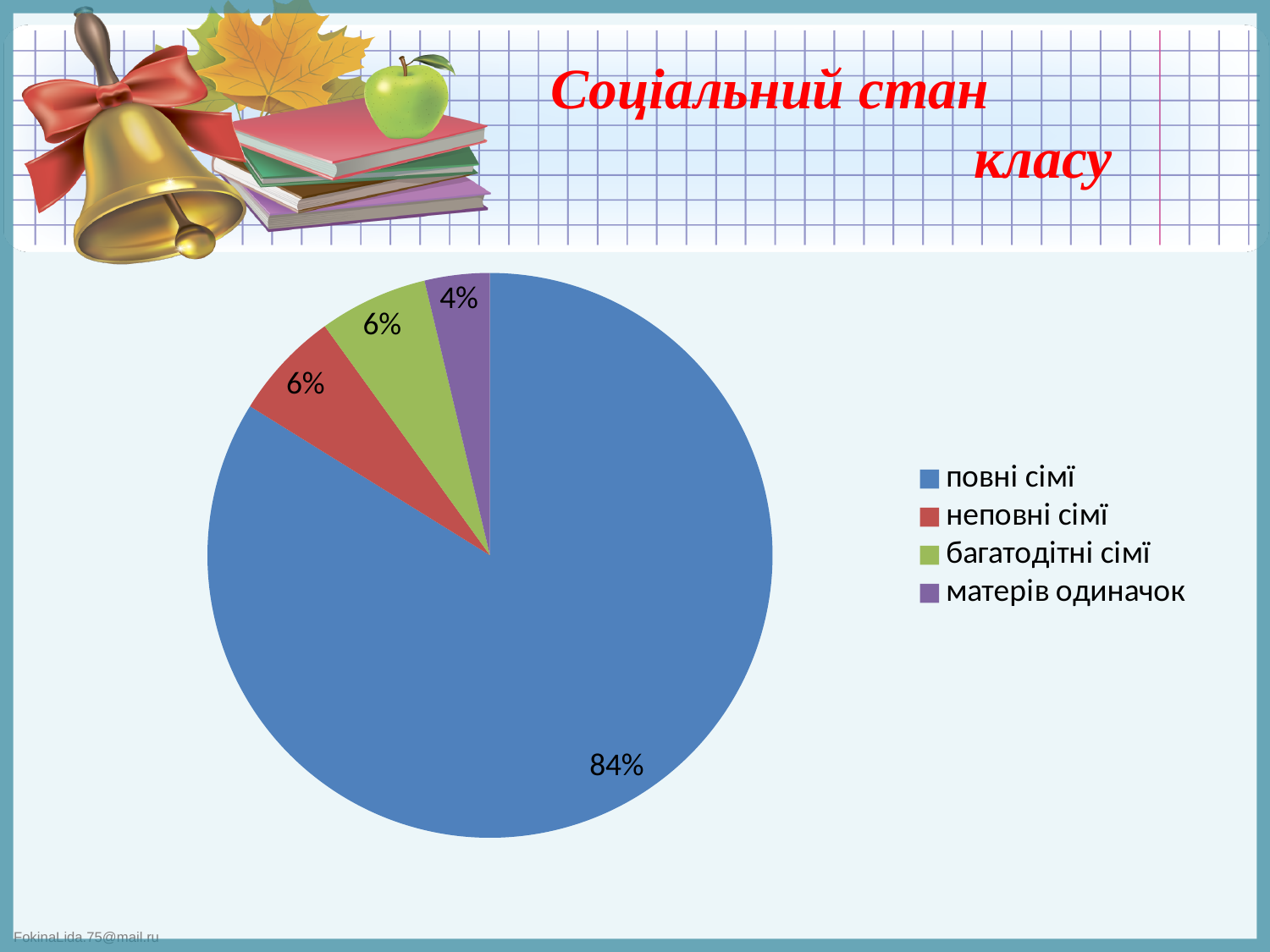
Which is larger, the slice for неповні сімї or the slice for матерів одиначок? неповні сімї What share of the pie is labelled for повні сімї? 84% What share of the pie is labelled for неповні сімї? 6% What is the title of the slide containing the chart? Соціальний стан класу How many categories does the pie chart show? 4 What share of the pie is labelled for багатодітні сімї? 6% What colour is the slice for повні сімї? blue Which category has the largest slice of the pie? повні сімї What is the difference in percentage points between повні сімї and матерів одиначок? 80 What kind of chart is shown on the slide? pie chart What share of the pie is labelled for матерів одиначок? 4% Which category has the smallest slice of the pie? матерів одиначок